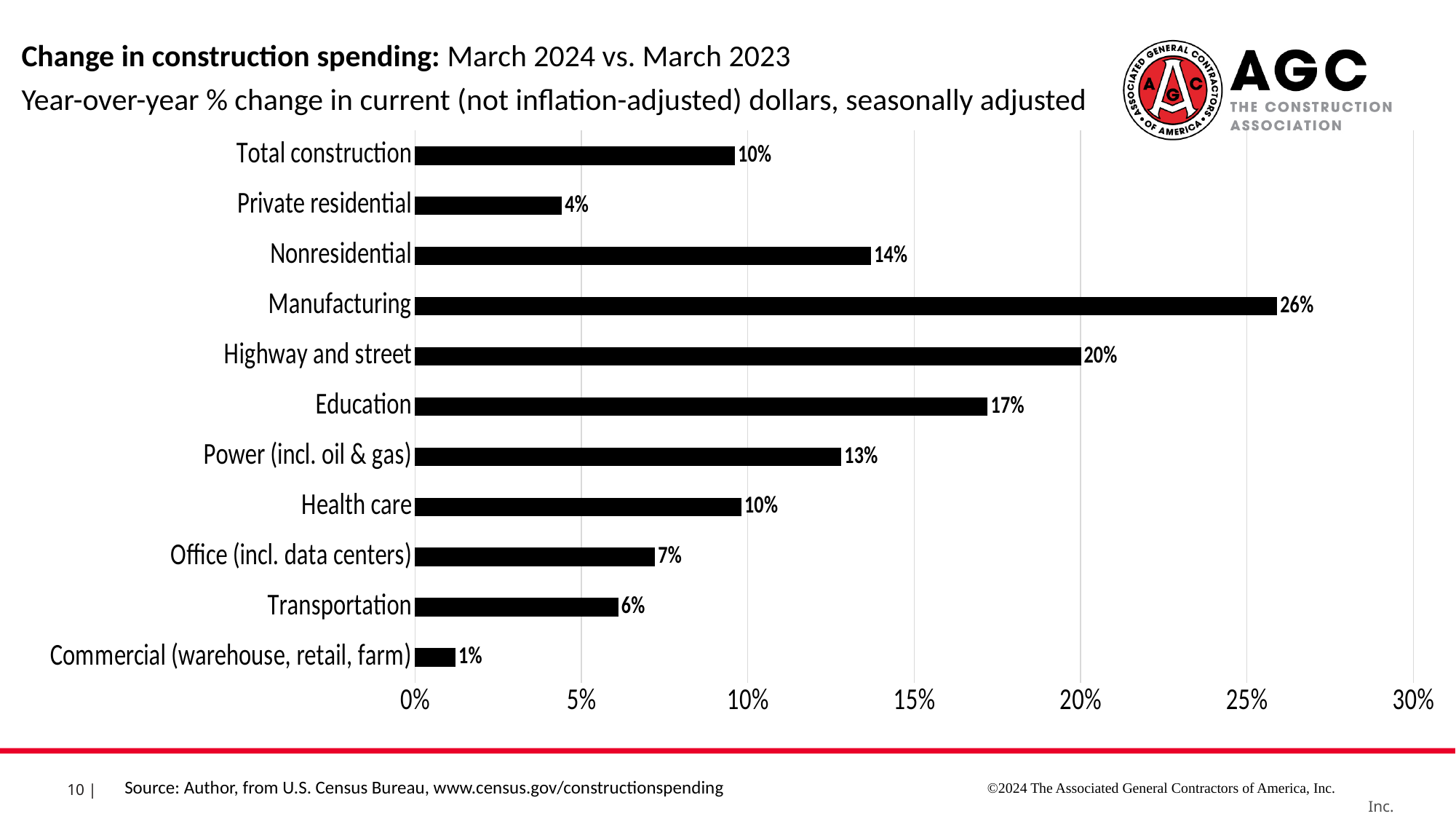
What is the year-over-year % change for Manufacturing? 26% What is the year-over-year % change for Office (incl. data centers)? 7% What is the difference between the % change for Manufacturing and the % change for Education? 9% What is the year-over-year % change for Highway and street? 20% What kind of chart is shown on the slide? Bar chart How many categories are shown in the chart? 11 What is the highest value shown on the x axis? 30% Which category has the lowest year-over-year % change? Commercial (warehouse, retail, farm) Is the value for Highway and street greater or less than 15%? greater Which category has the highest year-over-year % change? Manufacturing What is the year-over-year % change for Private residential? 4% Which has a larger year-over-year % change, Nonresidential or Power (incl. oil & gas)? Nonresidential